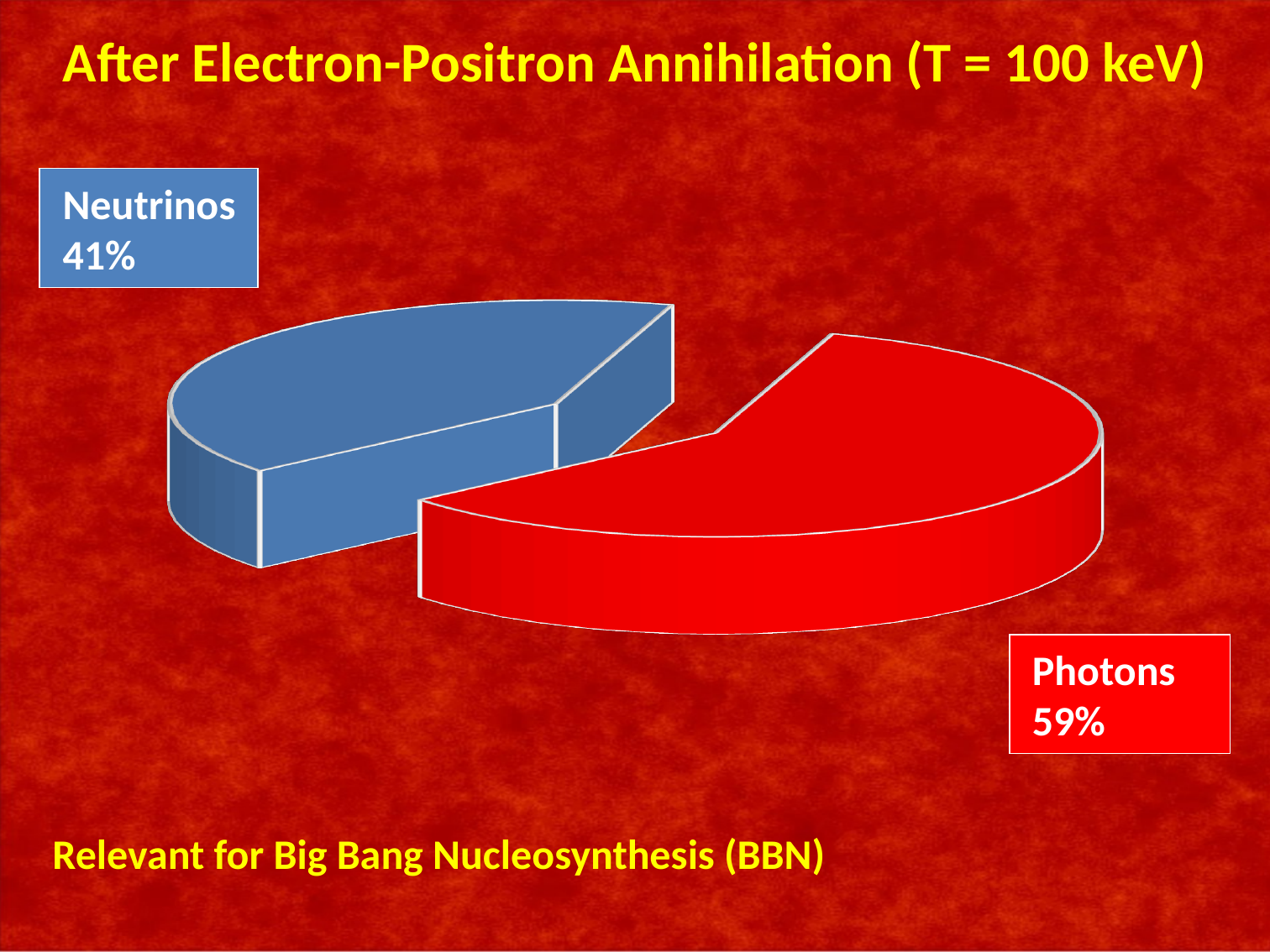
How many slices does the pie chart have? 2 What is the difference in percentage points between the Photons and Neutrinos slices? 18 Which is larger, the Photons slice or the Neutrinos slice? Photons What share of the pie do Photons account for? 59% What share of the pie do Neutrinos account for? 41% Which slice is the largest in the pie chart? Photons What colour is the Neutrinos slice of the pie chart? Blue Which slice is the smallest in the pie chart? Neutrinos What is the title of the slide containing the pie chart? After Electron-Positron Annihilation (T = 100 keV) What is the combined share of the Photons and Neutrinos slices? 100% What kind of chart is shown on the slide? Pie chart